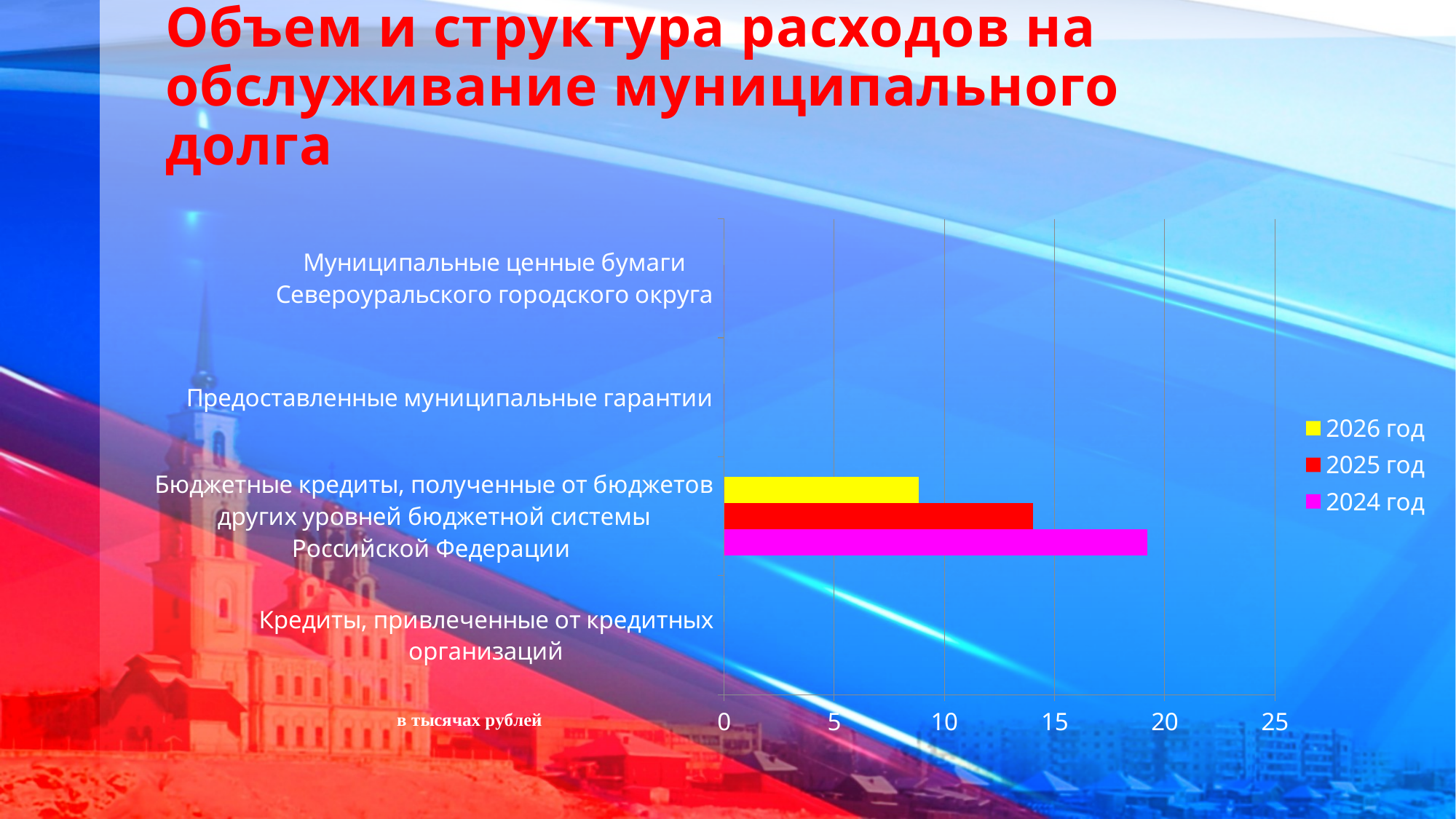
What kind of chart is shown on the slide? bar chart Is the value for 2024 год for 'Бюджетные кредиты, полученные от бюджетов других уровней бюджетной системы Российской Федерации' greater or less than 20? less What unit is stated below the chart for the values? в тысячах рублей Which series has the longest bar for the category 'Бюджетные кредиты, полученные от бюджетов других уровней бюджетной системы Российской Федерации'? 2024 год For 'Бюджетные кредиты, полученные от бюджетов других уровней бюджетной системы Российской Федерации', which is larger: the value for 2025 год or the value for 2026 год? 2025 год How many categories are shown on the vertical axis of the chart? 4 Is the value for 2026 год for 'Бюджетные кредиты, полученные от бюджетов других уровней бюджетной системы Российской Федерации' greater or less than 10? less Which series has the shortest bar for the category 'Бюджетные кредиты, полученные от бюджетов других уровней бюджетной системы Российской Федерации'? 2026 год Is the value for 2025 год for 'Бюджетные кредиты, полученные от бюджетов других уровней бюджетной системы Российской Федерации' greater or less than 10? greater Which colour represents the series '2024 год' in the legend? magenta How many series does the legend list? 3